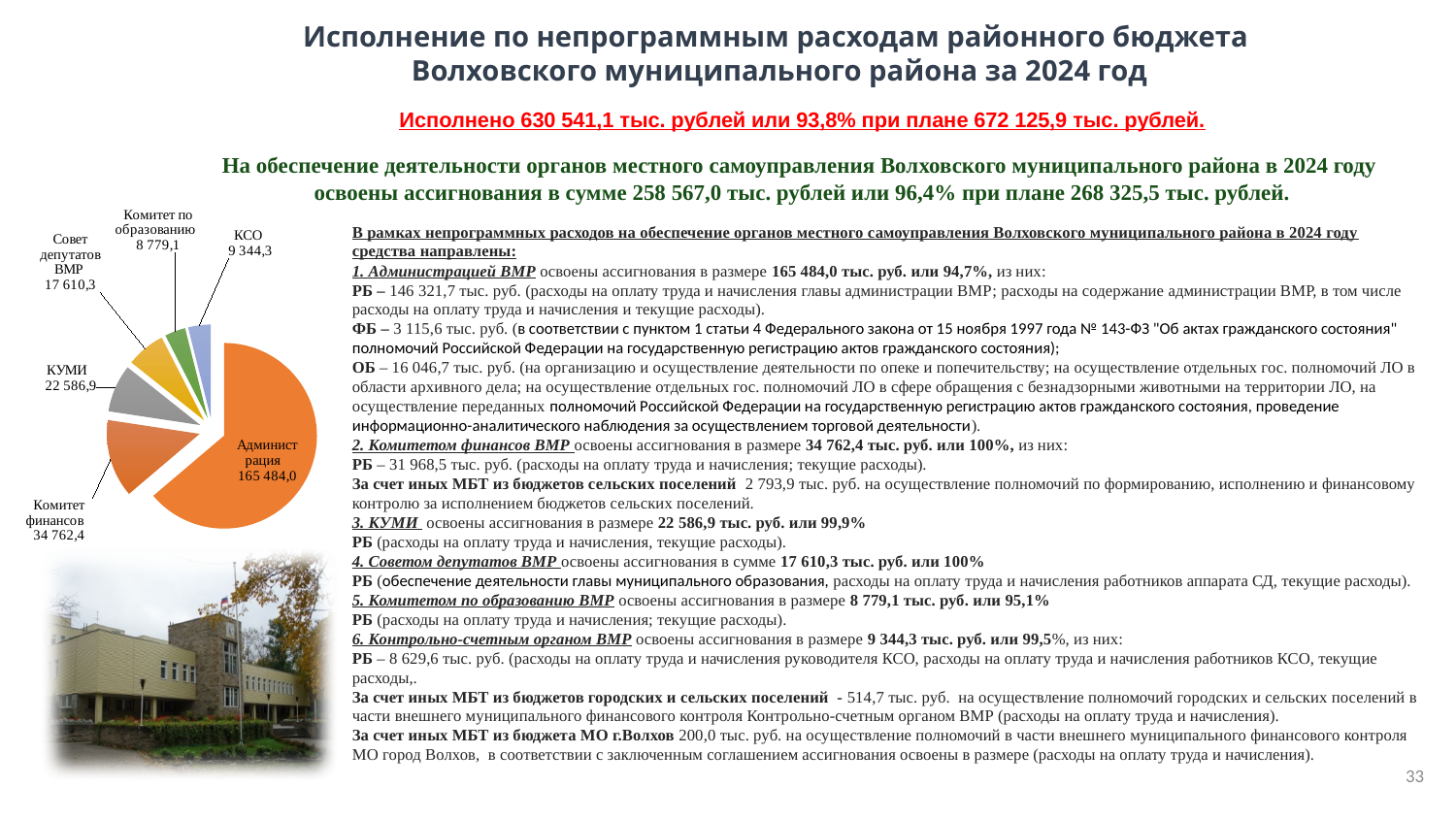
What type of chart is shown on the slide? pie chart What is the difference between the values for КУМИ and Совет депутатов ВМР in the pie chart? 4 976,6 What is the value shown for КУМИ in the pie chart? 22 586,9 What is the value shown for Совет депутатов ВМР in the pie chart? 17 610,3 What is the value shown for Администрация in the pie chart? 165 484,0 Which is larger in the pie chart: КСО or Комитет по образованию? КСО What is the value shown for КСО in the pie chart? 9 344,3 What is the difference between the values for Администрация and Комитет финансов in the pie chart? 130 721,6 Which category has the largest slice in the pie chart? Администрация What is the value shown for Комитет финансов in the pie chart? 34 762,4 Which category has the smallest slice in the pie chart? Комитет по образованию How many slices does the pie chart have? 6